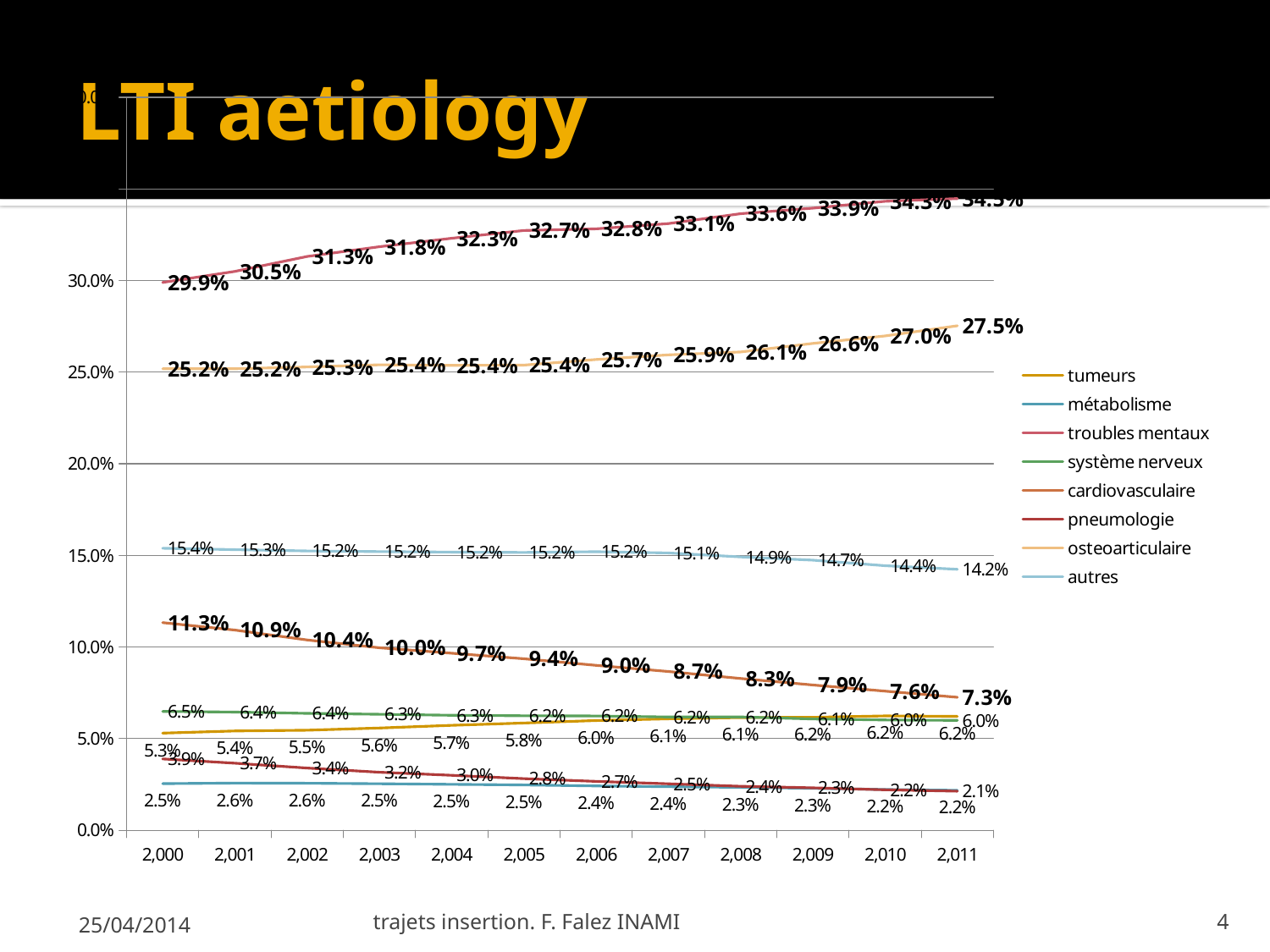
By how many percentage points did the cardiovasculaire value change between 2000 (11.3%) and 2011 (7.3%)? 4.0 percentage points In 2005, which is larger: troubles mentaux or osteoarticulaire? troubles mentaux What is the value for cardiovasculaire in 2000? 11.3% Does the troubles mentaux line rise or fall from 2000 to 2011? rises What is the value for troubles mentaux in 2000? 29.9% How many series does the legend list? 8 What is the value for autres in 2011? 14.2% What is the value for osteoarticulaire in 2011? 27.5% What kind of chart is shown on the slide? line chart How many years are plotted along the x axis? 12 Which series has the highest value in 2000? troubles mentaux Does the cardiovasculaire line rise or fall from 2000 to 2011? falls